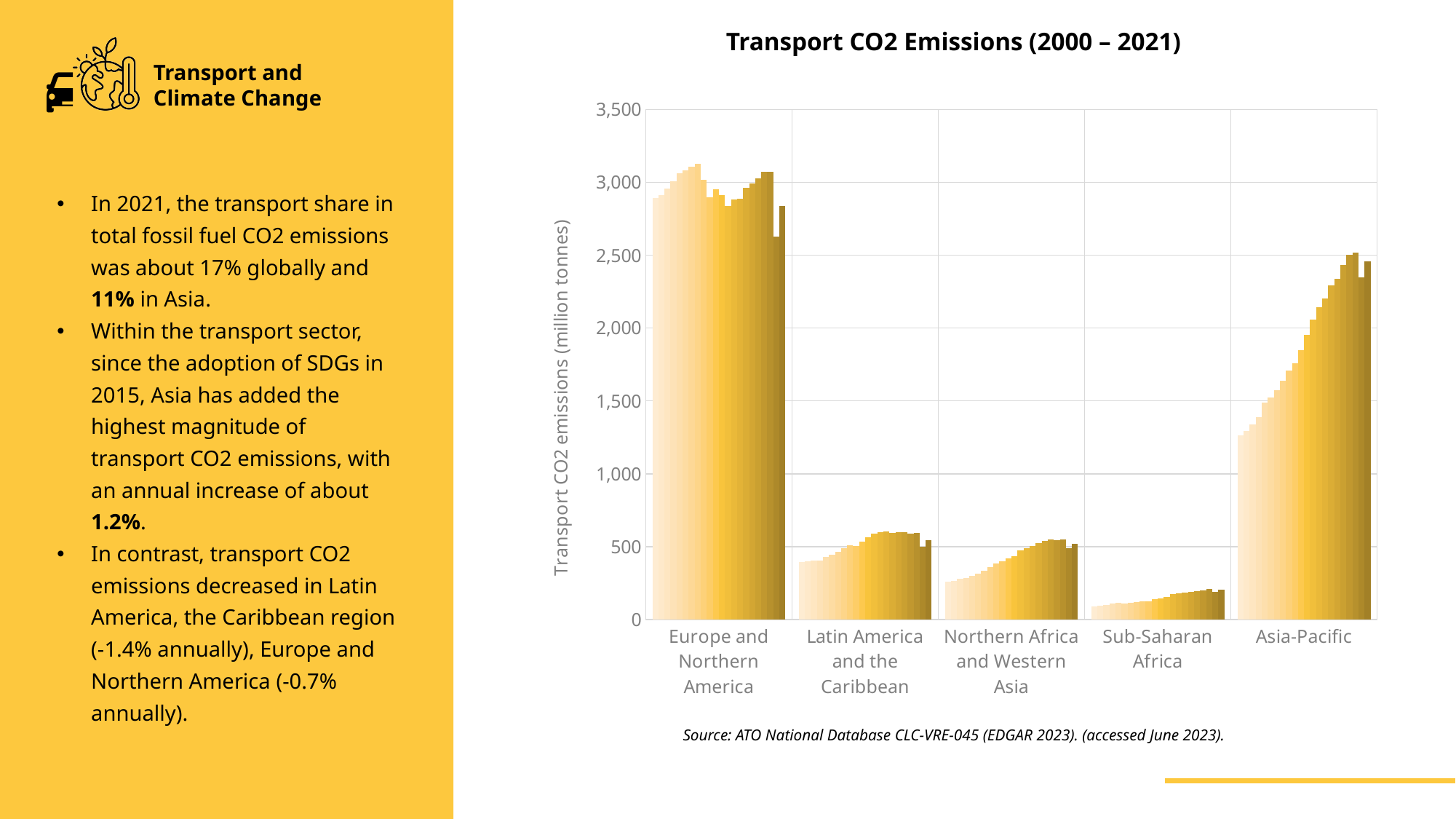
Which region has the lowest transport CO2 emissions in the chart? Sub-Saharan Africa Are the values for Latin America and the Caribbean greater or less than 1,000 million tonnes? less Is the most recent value for Asia-Pacific greater or less than 2,000 million tonnes? greater What is the title of the chart? Transport CO2 Emissions (2000 – 2021) How many regions are shown along the x axis of the chart? 5 What kind of chart is shown on the slide? bar chart What is the label on the vertical axis of the chart? Transport CO2 emissions (million tonnes) Which region has higher transport CO2 emissions, Latin America and the Caribbean or Sub-Saharan Africa? Latin America and the Caribbean Are the transport CO2 emissions for Sub-Saharan Africa greater or less than 500 million tonnes in every year shown? less Which region has the highest transport CO2 emissions in the chart? Europe and Northern America Do the transport CO2 emissions for Asia-Pacific rise or fall over the years shown? rise Which region has higher transport CO2 emissions, Asia-Pacific or Northern Africa and Western Asia? Asia-Pacific